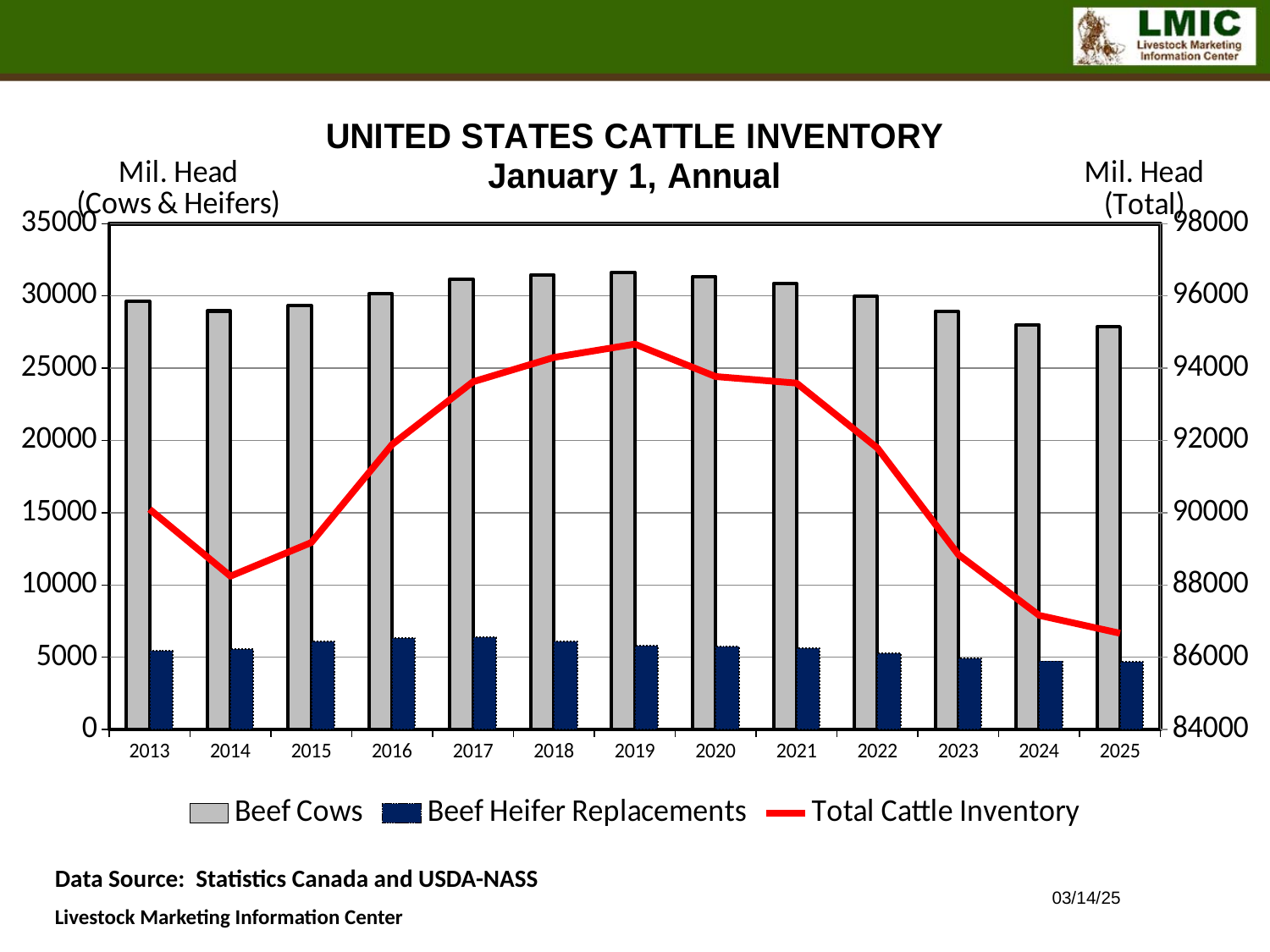
Is the Beef Cows value for 2014 greater or less than 30000? less Is the Beef Heifer Replacements value for 2024 greater or less than 5000? less How many years are shown on the x axis? 13 In which year is the Total Cattle Inventory line at its highest? 2019 In which year is the Total Cattle Inventory line at its lowest? 2025 Which year has the larger Total Cattle Inventory, 2021 or 2022? 2021 What kind of chart is shown on the slide? A combined bar and line chart What is the title of the chart? UNITED STATES CATTLE INVENTORY January 1, Annual Is the Total Cattle Inventory value for 2025 greater or less than 88000? less How many series does the legend list? 3 Does the Total Cattle Inventory line rise or fall from 2019 to 2025? It falls